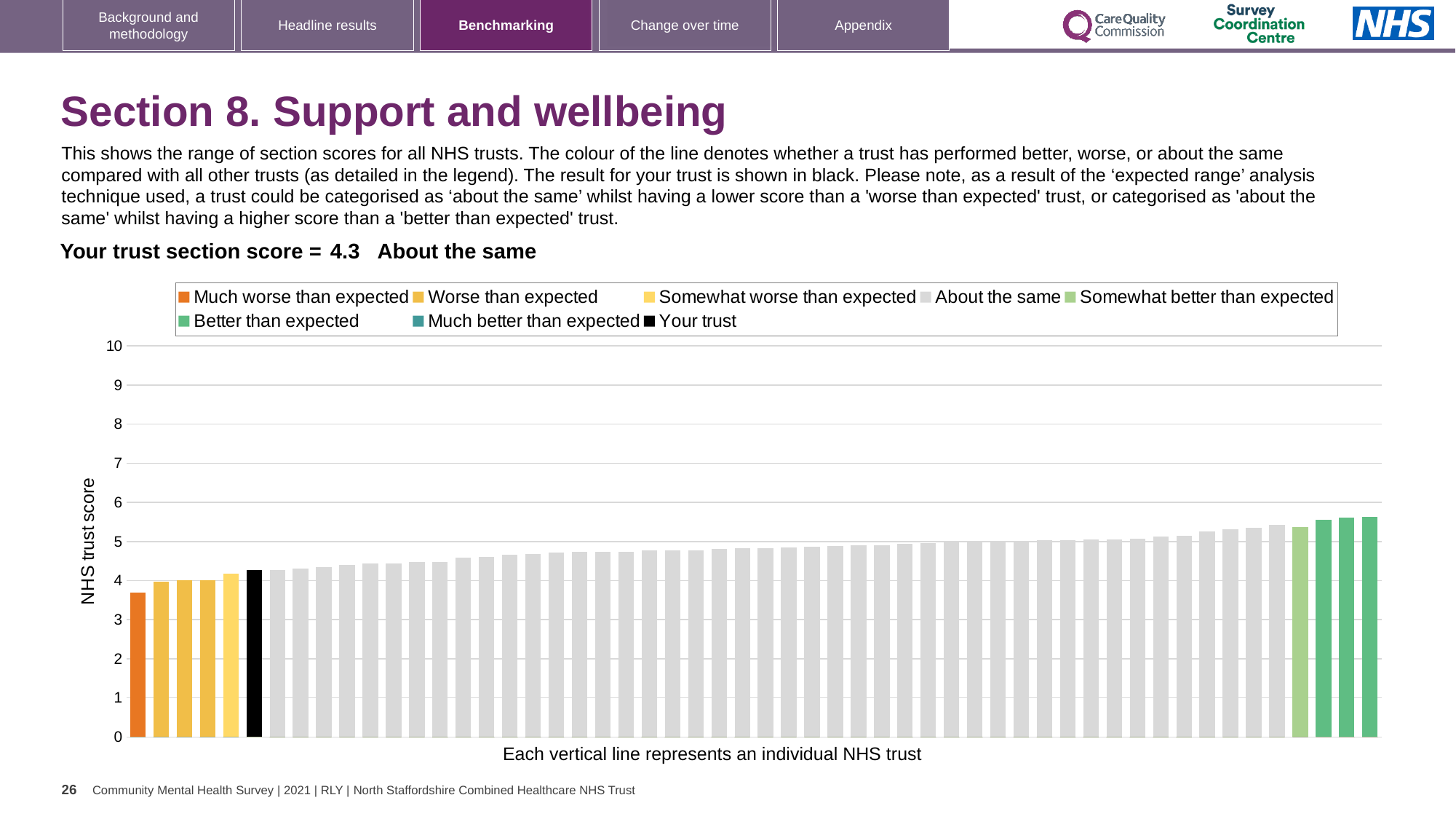
What is the section score for your trust shown on the slide? 4.3 How many entries does the chart legend list? 8 Is the value for your trust (black bar) greater or less than 5? less Which legend category does the highest bar on the chart belong to? Better than expected Is the value of the tallest bar on the chart greater or less than 6? less How many bars are coloured as 'Better than expected' (dark green)? 3 What kind of chart is shown on the slide? bar chart Which legend category does the lowest bar on the chart belong to? Much worse than expected Do the bar values rise or fall from left to right along the x axis? rise Which category is your trust placed in for this section? About the same Is the value of the orange 'Much worse than expected' bar greater or less than 4? less What is the label on the vertical axis of the chart? NHS trust score